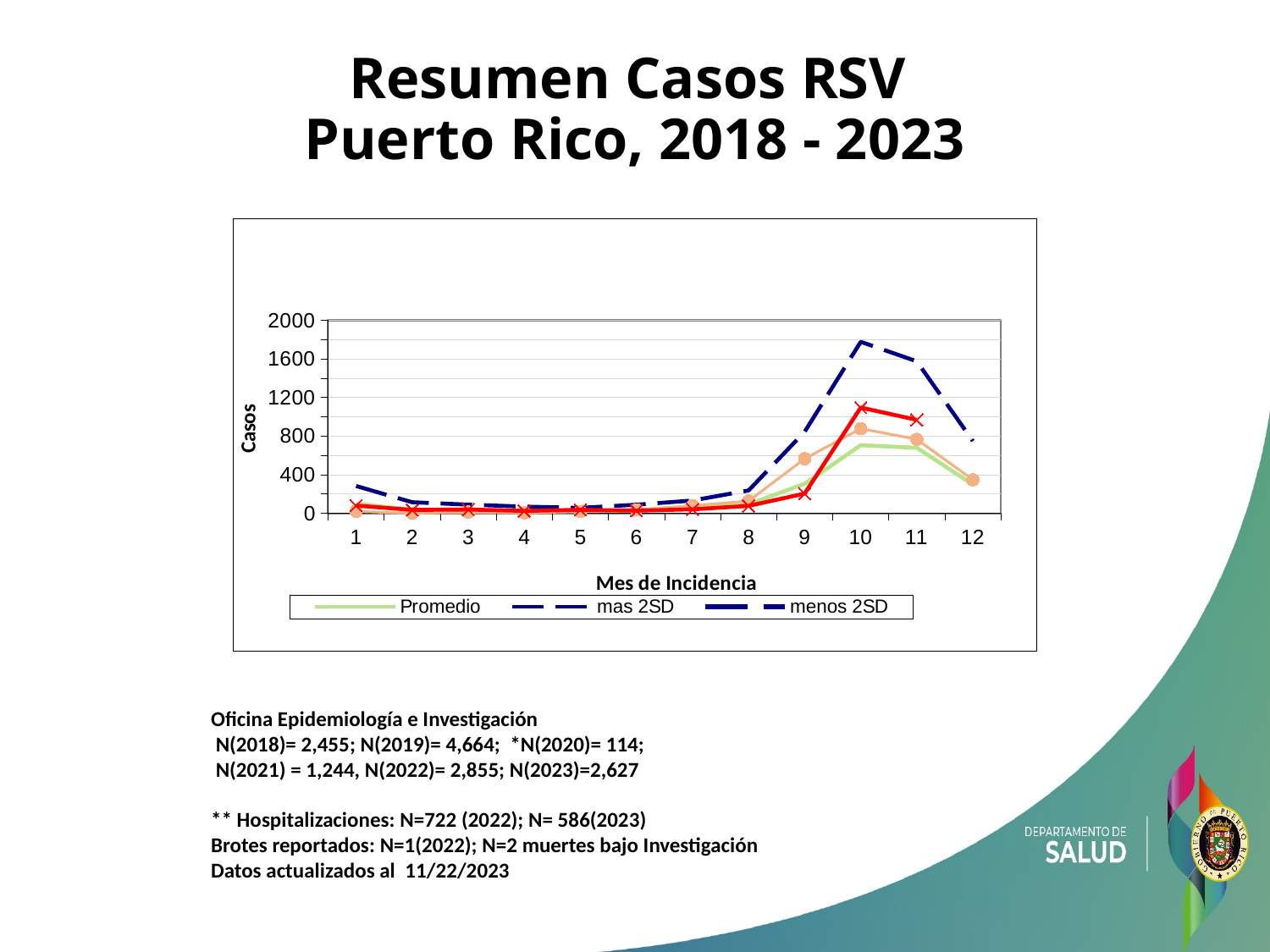
What is the title of the chart's y axis? Casos How many series does the chart's legend list? 3 Does the 'Promedio' series rise or fall from month 7 to month 10? rise What is the title of the chart's x axis? Mes de Incidencia Is the value of the 'mas 2SD' series in month 10 greater or less than 1600? greater How many months are plotted along the x axis of the chart? 12 In which month does the 'mas 2SD' series reach its highest value? 10 Is the value of the 'Promedio' series in month 5 greater or less than 400? less In month 10, which series has the larger value: 'mas 2SD' or 'Promedio'? mas 2SD What kind of chart is shown on the slide? line chart Is the value of the 'Promedio' series in month 10 greater or less than 800? less